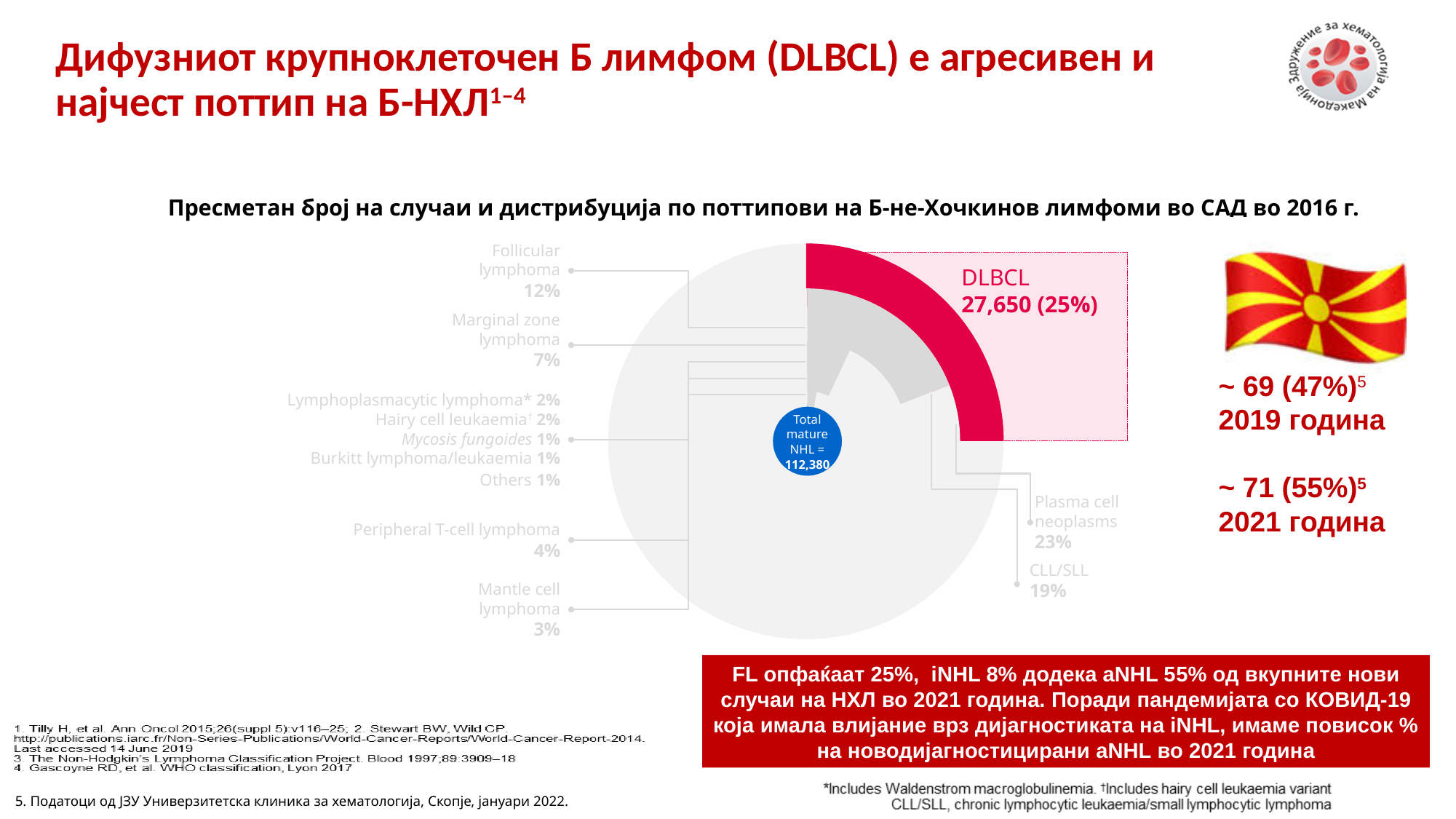
Which subtype has the largest share in the pie chart? DLBCL What is the estimated number of DLBCL cases shown on the chart? 27,650 What share of cases does DLBCL account for in the pie chart? 25% What is the total number of mature NHL cases shown in the centre of the chart? 112,380 What percentage of cases is attributed to CLL/SLL? 19% What is the difference in percentage points between DLBCL and CLL/SLL? 6 Which has a larger share, Marginal zone lymphoma or Mantle cell lymphoma? Marginal zone lymphoma What percentage of cases is attributed to Peripheral T-cell lymphoma? 4% What type of chart is used to show the distribution of B-NHL subtypes? Pie chart How many subtype categories are labelled on the pie chart? 12 What percentage of cases is attributed to Plasma cell neoplasms? 23% What percentage of cases is attributed to Follicular lymphoma? 12%